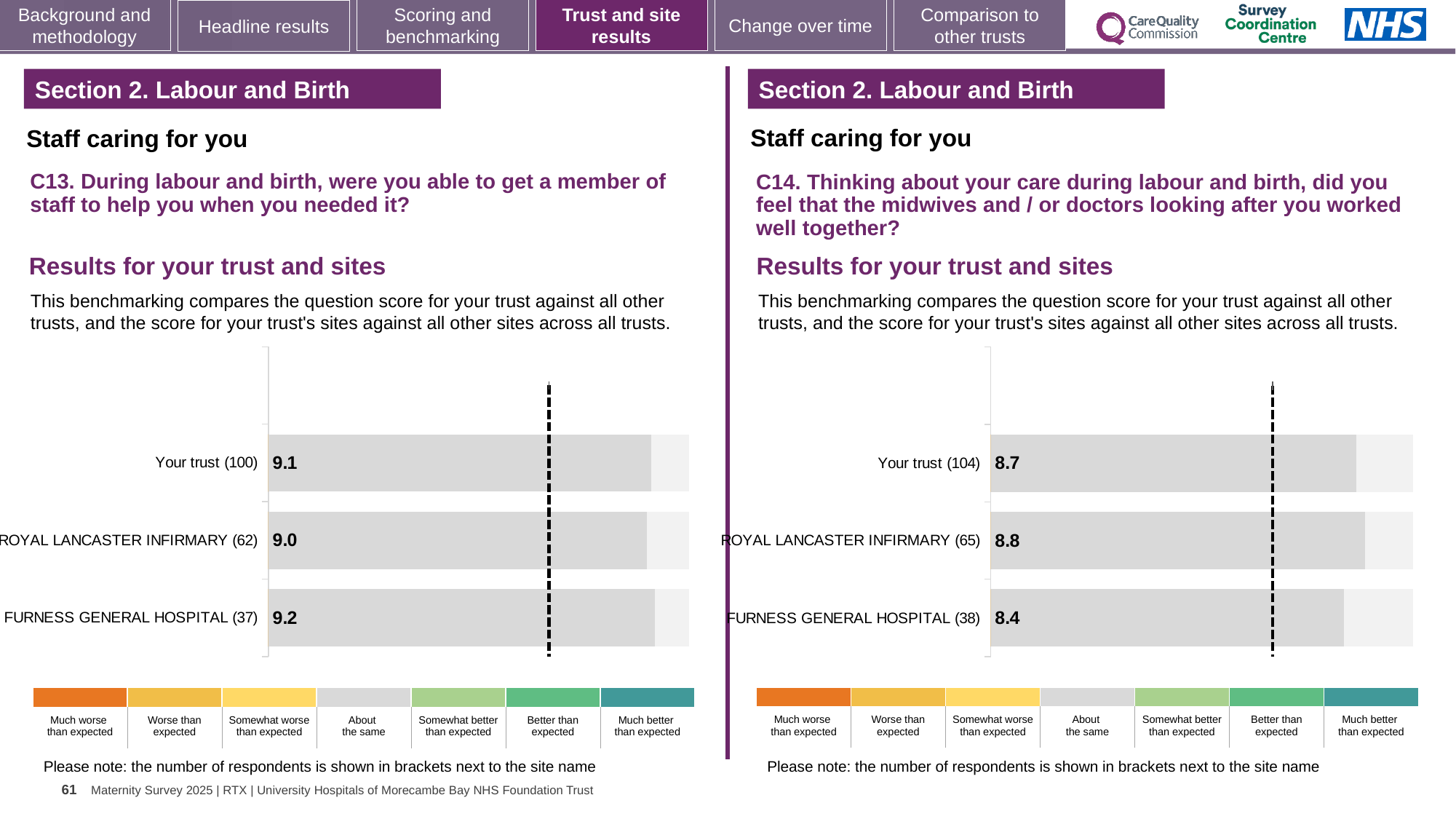
In the C14 chart on the right, what is the score for Your trust (104)? 8.7 In the C14 chart on the right, which site or trust has the highest score? ROYAL LANCASTER INFIRMARY (65) In the C13 chart on the left, what is the score for Your trust (100)? 9.1 What type of chart is used in the C14 chart on the right? Bar chart In the C13 chart on the left, what is the difference between the scores for FURNESS GENERAL HOSPITAL (37) and ROYAL LANCASTER INFIRMARY (62)? 0.2 In the C14 chart on the right, what is the score for FURNESS GENERAL HOSPITAL (38)? 8.4 How many bars are plotted in the C13 chart on the left? 3 In the C13 chart on the left, what is the score for ROYAL LANCASTER INFIRMARY (62)? 9.0 In the C14 chart on the right, which site or trust has the lowest score? FURNESS GENERAL HOSPITAL (38) In the C13 chart on the left, what is the score for FURNESS GENERAL HOSPITAL (37)? 9.2 In the C14 chart on the right, what is the difference between the scores for ROYAL LANCASTER INFIRMARY (65) and FURNESS GENERAL HOSPITAL (38)? 0.4 In the C13 chart on the left, how many respondents are shown in brackets for Your trust? 100